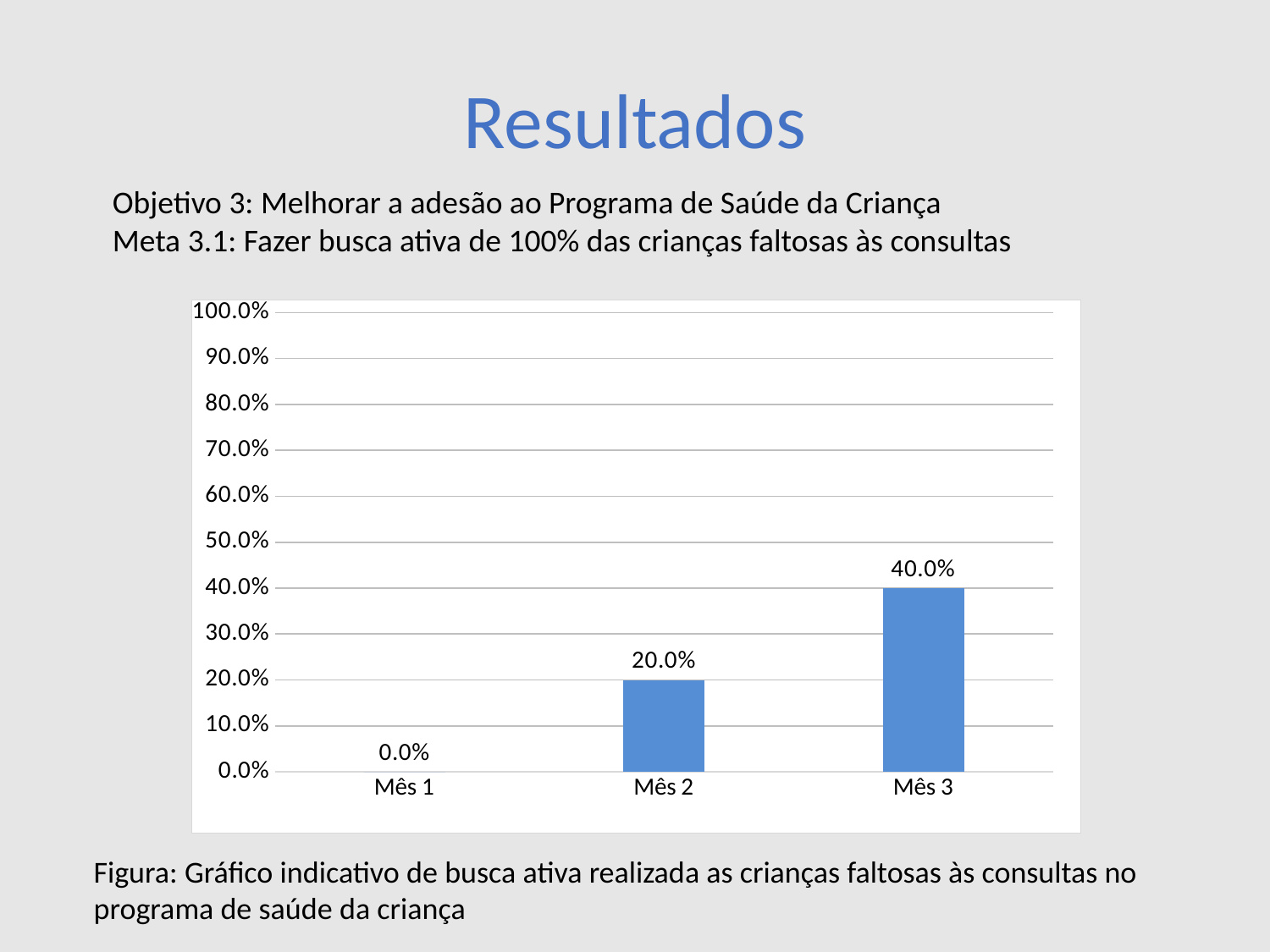
What kind of chart is shown on the slide? bar chart Do the values rise or fall from Mês 1 to Mês 3? rise Is the value for Mês 3 greater or less than 50.0%? less What is the value for Mês 2? 20.0% How many months are shown on the x axis? 3 Which month has the lowest value? Mês 1 What is the maximum value shown on the y axis? 100.0% What is the value for Mês 3? 40.0% Which is larger, the value for Mês 2 or the value for Mês 3? Mês 3 What is the value for Mês 1? 0.0% What is the difference between the values for Mês 3 and Mês 2? 20.0% Which month has the highest value? Mês 3